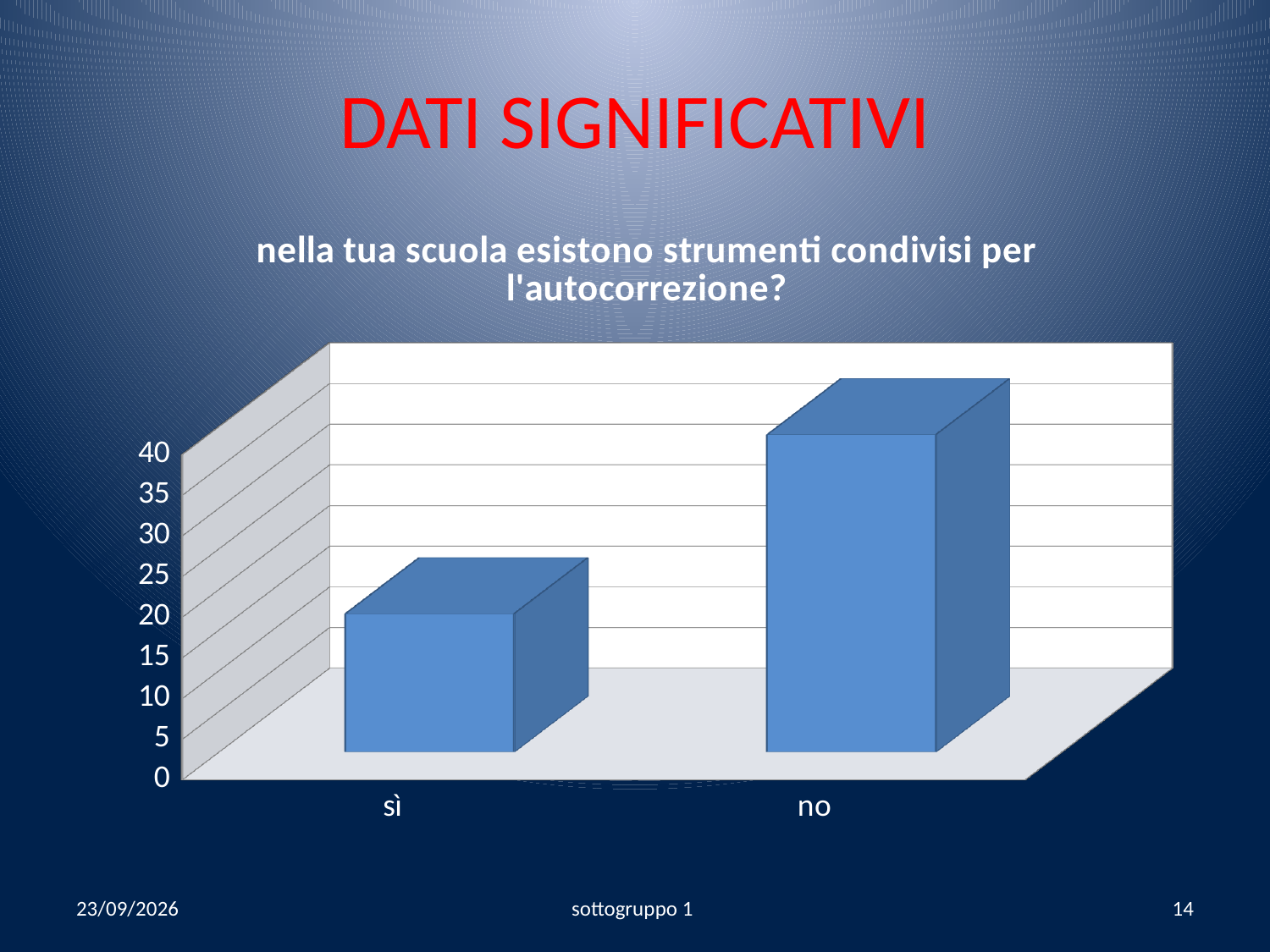
Which category has the lowest bar in the chart? sì Which bar is taller, sì or no? no Is the value for sì greater or less than 30? less How many categories are shown on the x axis of the chart? 2 Is the value for no greater or less than 30? greater Is the value for sì greater or less than 10? greater What is the highest tick value shown on the vertical axis of the chart? 40 What kind of chart is shown on the slide? bar chart What is the title of the chart? nella tua scuola esistono strumenti condivisi per l'autocorrezione? Which category has the highest bar in the chart? no